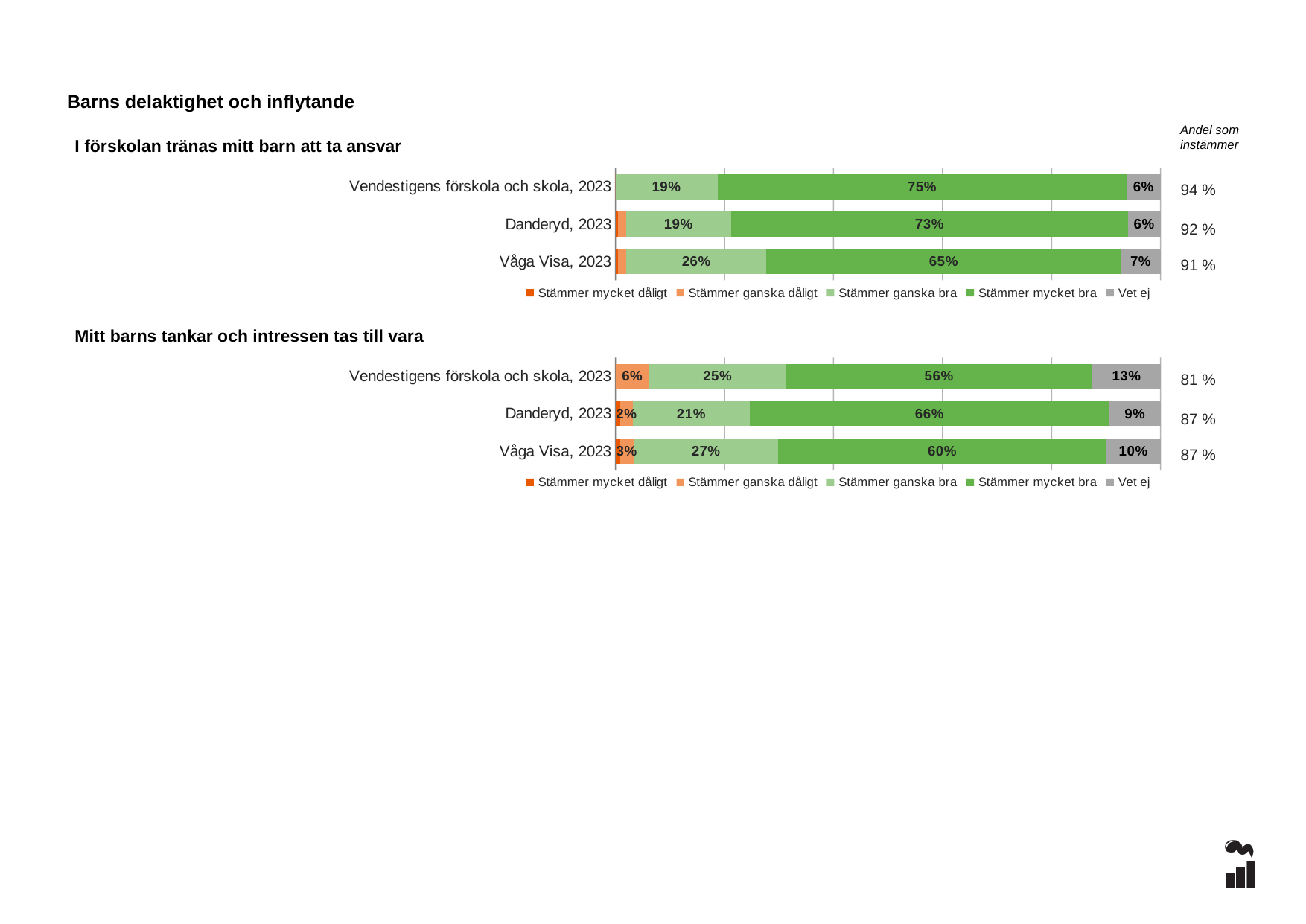
What kind of chart is 'Mitt barns tankar och intressen tas till vara'? Stacked bar chart In the chart 'Mitt barns tankar och intressen tas till vara', which row has the lowest 'Stämmer mycket bra' value? Vendestigens förskola och skola, 2023 In the chart 'I förskolan tränas mitt barn att ta ansvar', what is the 'Andel som instämmer' for Danderyd, 2023? 92 % In the chart 'I förskolan tränas mitt barn att ta ansvar', what is the 'Stämmer ganska bra' value for Våga Visa, 2023? 26% How many series does the legend of the chart 'Mitt barns tankar och intressen tas till vara' list? 5 In the chart 'I förskolan tränas mitt barn att ta ansvar', which row has the highest 'Stämmer mycket bra' value? Vendestigens förskola och skola, 2023 In the chart 'I förskolan tränas mitt barn att ta ansvar', what is the 'Stämmer mycket bra' value for Vendestigens förskola och skola, 2023? 75% How many rows (categories) are shown in the chart 'I förskolan tränas mitt barn att ta ansvar'? 3 In the chart 'Mitt barns tankar och intressen tas till vara', what is the 'Andel som instämmer' for Vendestigens förskola och skola, 2023? 81 % In the chart 'I förskolan tränas mitt barn att ta ansvar', what is the difference between the 'Stämmer mycket bra' values for Vendestigens förskola och skola, 2023 and Våga Visa, 2023? 10% In the chart 'Mitt barns tankar och intressen tas till vara', what is the 'Vet ej' value for Vendestigens förskola och skola, 2023? 13% In the chart 'Mitt barns tankar och intressen tas till vara', is the 'Stämmer mycket bra' value larger for Danderyd, 2023 or Våga Visa, 2023? Danderyd, 2023